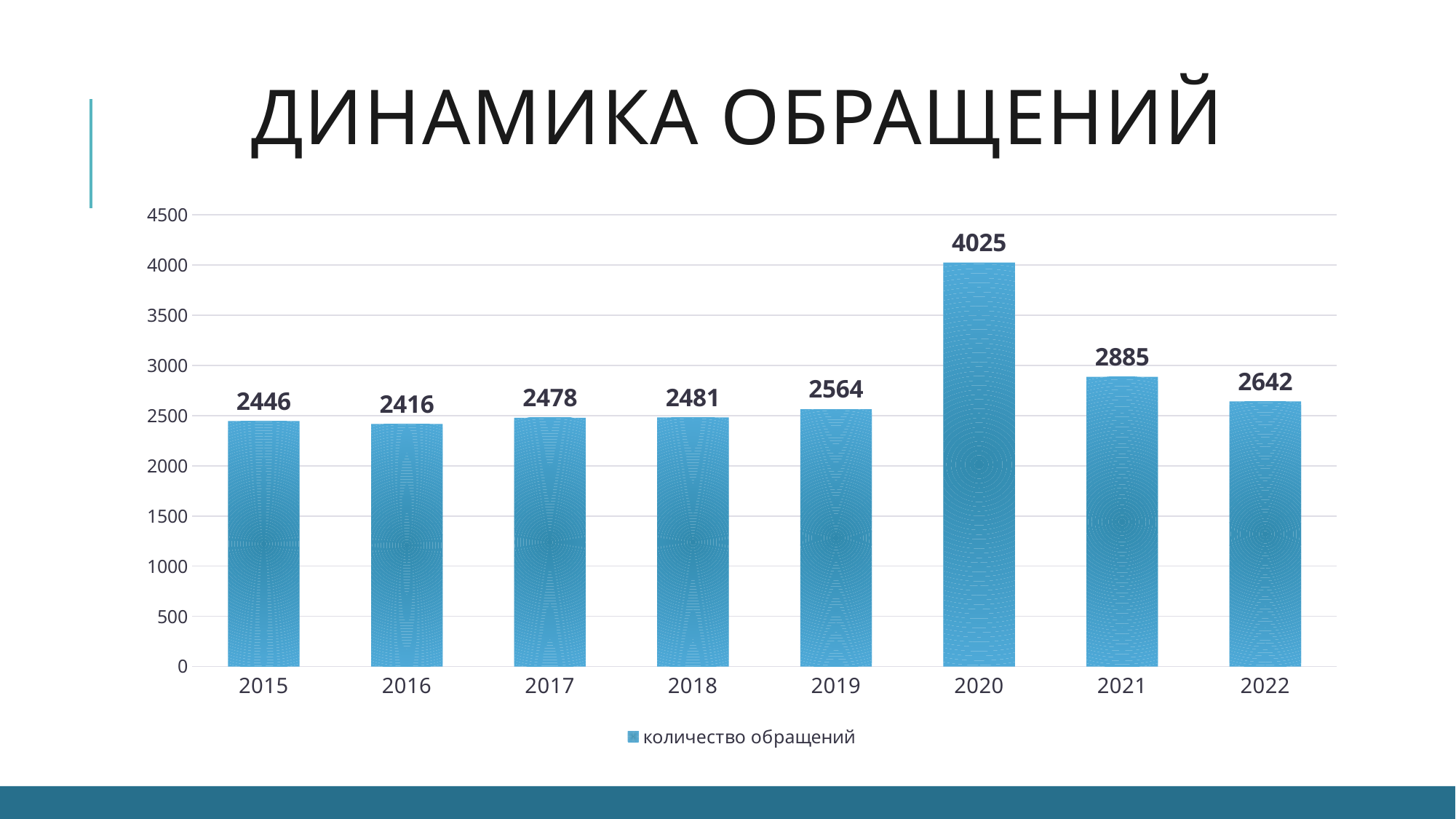
What is the difference between the values for 2019 and 2018? 83 What is the value for 2016? 2416 What is the value for 2020? 4025 What is the value for 2022? 2642 What is the difference between the values for 2020 and 2021? 1140 What is the legend entry for the series? количество обращений Which year has the highest value? 2020 What kind of chart is shown on the slide? bar chart Which is larger, the value for 2021 or the value for 2022? 2021 Is the value for 2020 greater or less than 4000? greater Which year has the lowest value? 2016 How many years are shown on the x axis? 8